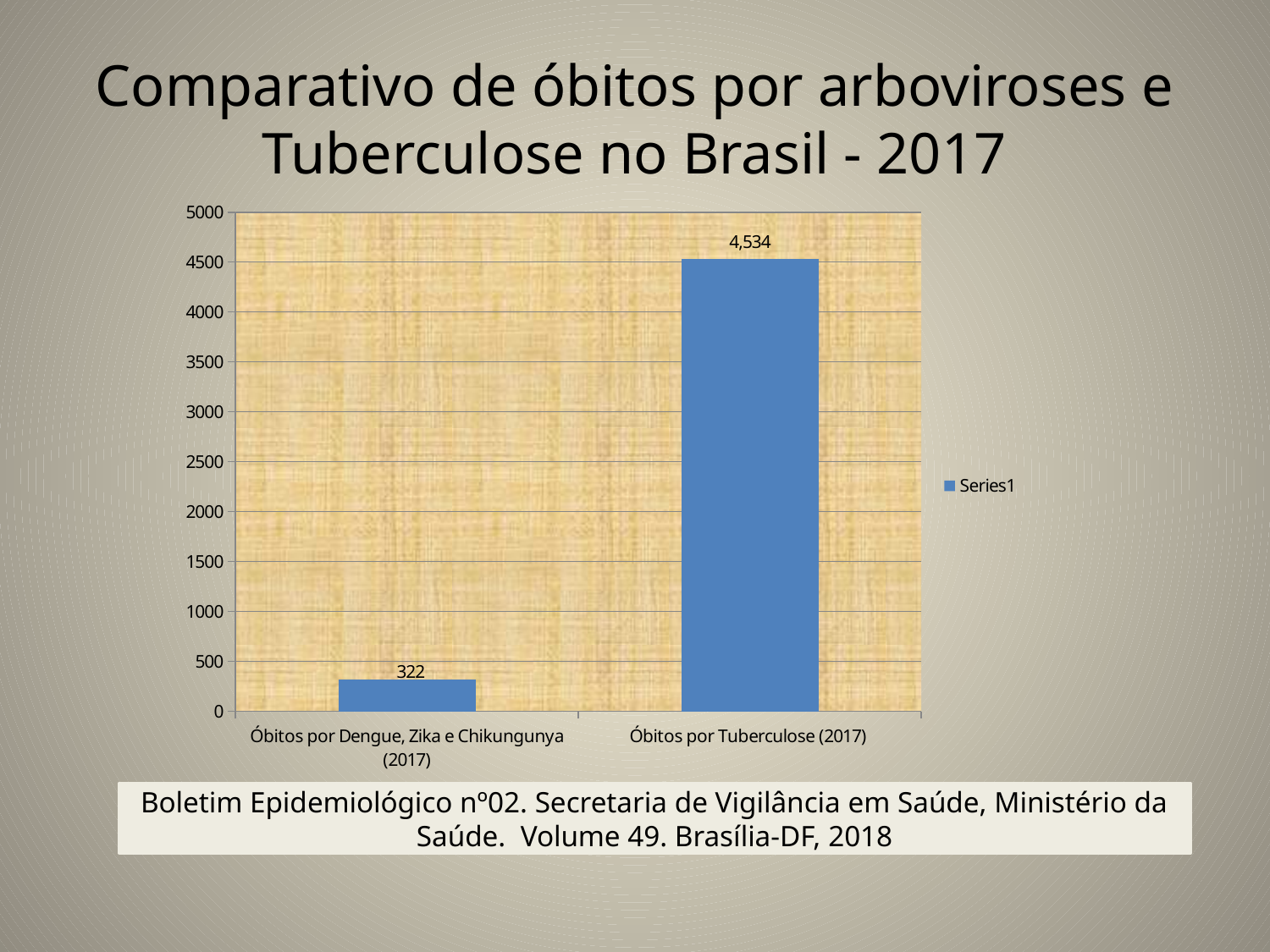
Which is larger: the value for Óbitos por Tuberculose (2017) or the value for Óbitos por Dengue, Zika e Chikungunya (2017)? Óbitos por Tuberculose (2017) What is the value for Óbitos por Dengue, Zika e Chikungunya (2017)? 322 Is the value for Óbitos por Dengue, Zika e Chikungunya (2017) greater or less than 500? less Which category has the lowest value? Óbitos por Dengue, Zika e Chikungunya (2017) What is the difference between the value for Óbitos por Tuberculose (2017) and the value for Óbitos por Dengue, Zika e Chikungunya (2017)? 4,212 How many categories are shown on the x axis? 2 What kind of chart is shown on the slide? bar chart Is the value for Óbitos por Tuberculose (2017) greater or less than 4000? greater What is the value for Óbitos por Tuberculose (2017)? 4,534 How many series does the legend list? 1 Which category has the highest value? Óbitos por Tuberculose (2017) What is the name of the series listed in the legend? Series1